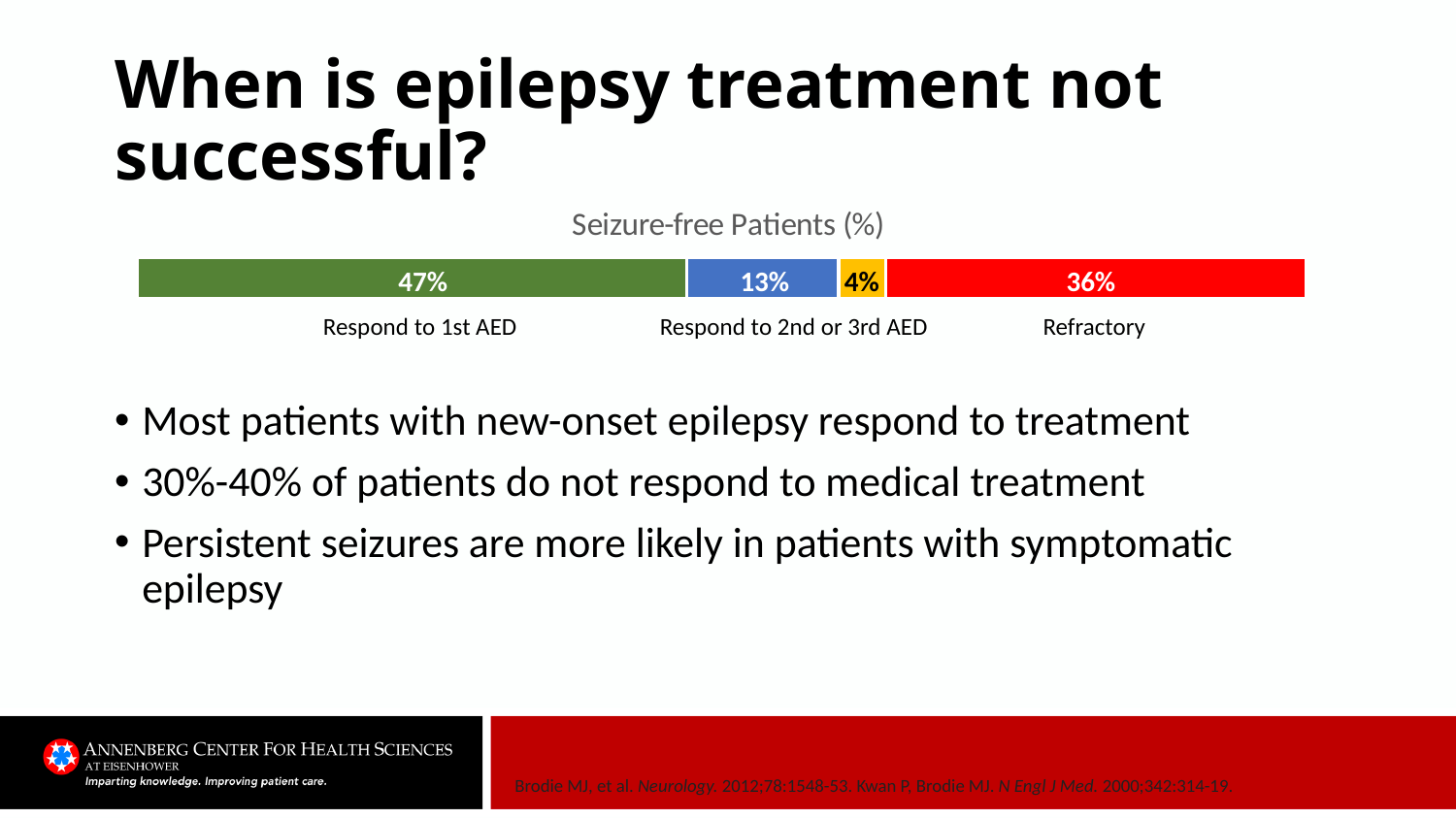
What is the title of the chart on the slide? Seizure-free Patients (%) Which is larger, the Respond to 1st AED segment or the Refractory segment? Respond to 1st AED What percentage of patients are labelled Refractory in the chart? 36% What value is shown on the blue segment of the bar? 13% What kind of chart is shown on the slide? Stacked bar chart Which segment of the bar has the largest value? Respond to 1st AED (47%) How many segments make up the stacked bar? 4 What value is shown on the yellow segment of the bar? 4% What percentage of patients respond to the 1st AED according to the chart? 47% What is the smallest value shown on the bar? 4% What is the total of all the segments in the stacked bar? 100% How many percentage points larger is the Respond to 1st AED segment than the Refractory segment? 11 percentage points